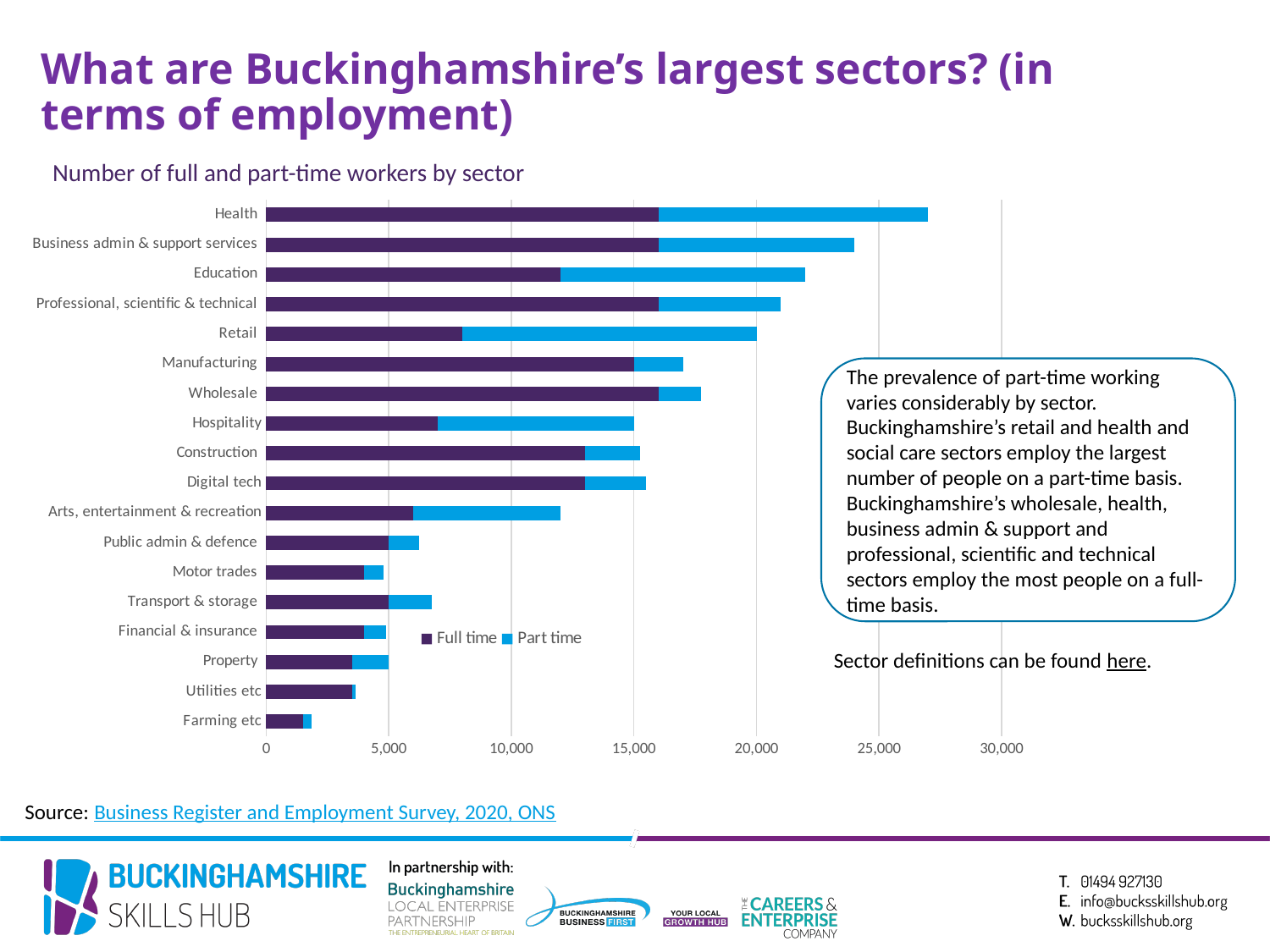
What are the two series named in the legend? Full time, Part time Is the total number of workers for Health greater or less than 25,000? greater Is the total number of workers for Farming etc greater or less than 5,000? less Which sector has the smallest total number of workers? Farming etc Is the total number of workers for Arts, entertainment & recreation greater or less than 10,000? greater Which sector has more full-time workers, Retail or Education? Education How many series does the legend list? 2 Which sector has more workers in total, Education or Manufacturing? Education What kind of chart is shown on the slide? Bar chart How many sectors are plotted on the chart? 18 Which sector has the largest total number of workers? Health